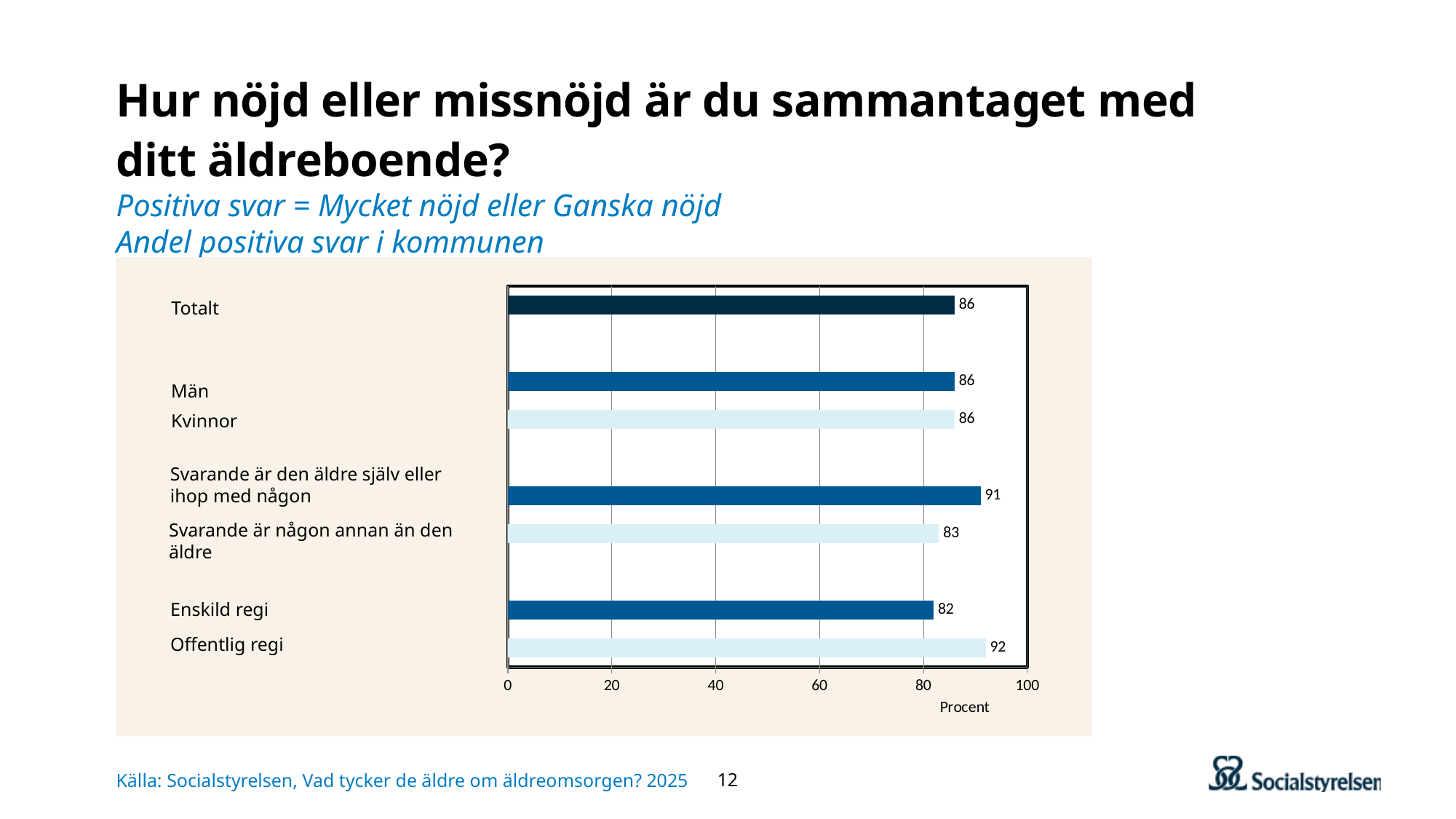
Which is larger, the value for Svarande är den äldre själv eller ihop med någon or the value for Svarande är någon annan än den äldre? Svarande är den äldre själv eller ihop med någon What is the value for Offentlig regi? 92 What is the label of the horizontal axis? Procent Which category has the lowest value? Enskild regi How many bars are plotted in the chart? 7 What is the difference between the values for Offentlig regi and Enskild regi? 10 What is the difference between the values for Svarande är den äldre själv eller ihop med någon and Svarande är någon annan än den äldre? 8 What kind of chart is shown on the slide? Bar chart What is the value for Enskild regi? 82 What is the value for Totalt? 86 What is the value for Svarande är den äldre själv eller ihop med någon? 91 Which category has the highest value? Offentlig regi